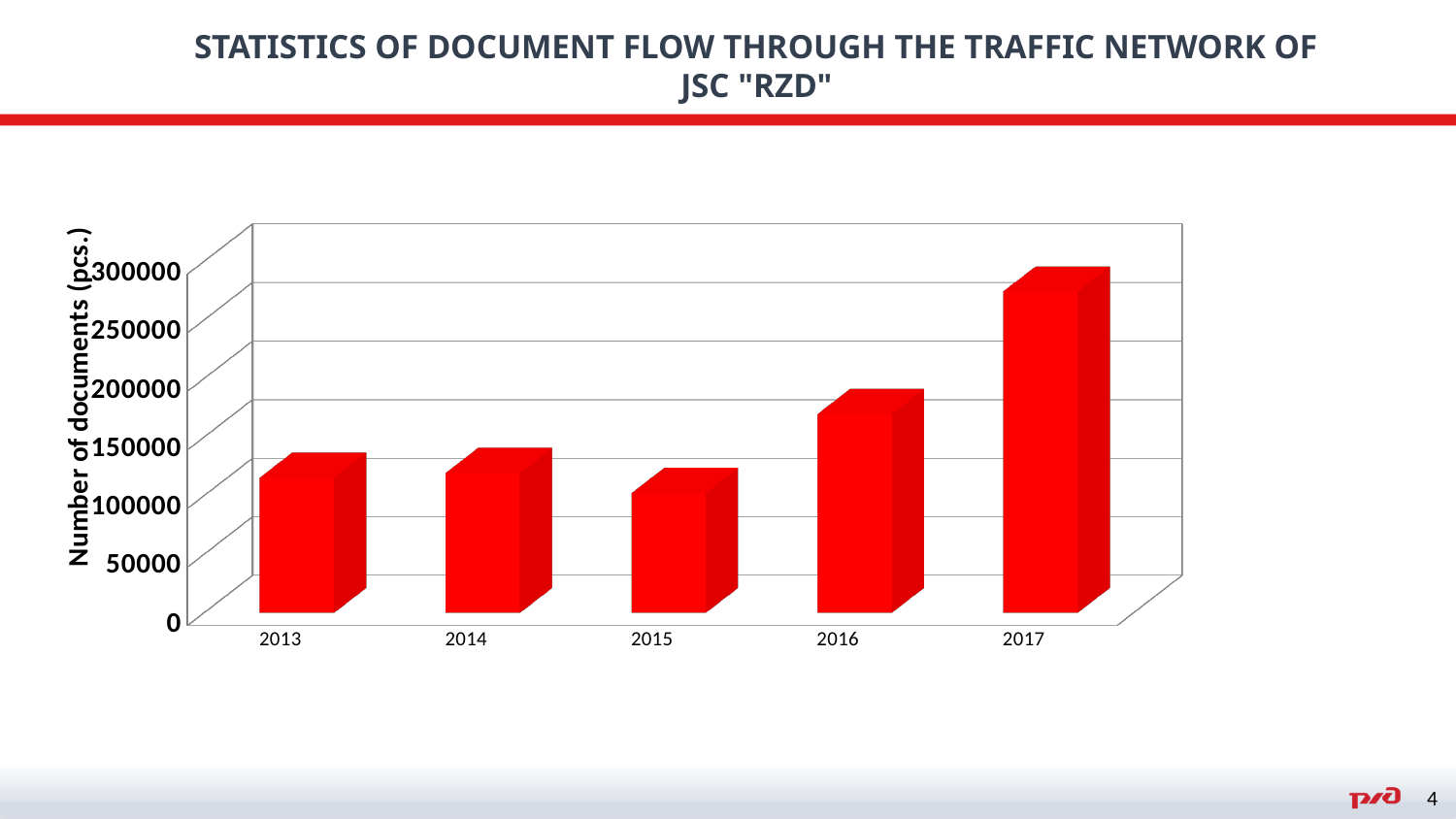
Which year has the lowest number of documents? 2015 Is the value for 2014 greater or less than 150000? less Which year has a larger value, 2015 or 2017? 2017 Is the value for 2015 greater or less than 150000? less What colour are the bars in the chart? red Is the value for 2016 greater or less than 150000? greater Which year has the highest number of documents? 2017 Which year has a larger value, 2016 or 2013? 2016 How many years are shown on the x axis of the chart? 5 What is the title of the vertical axis? Number of documents (pcs.) What kind of chart is shown on the slide? bar chart